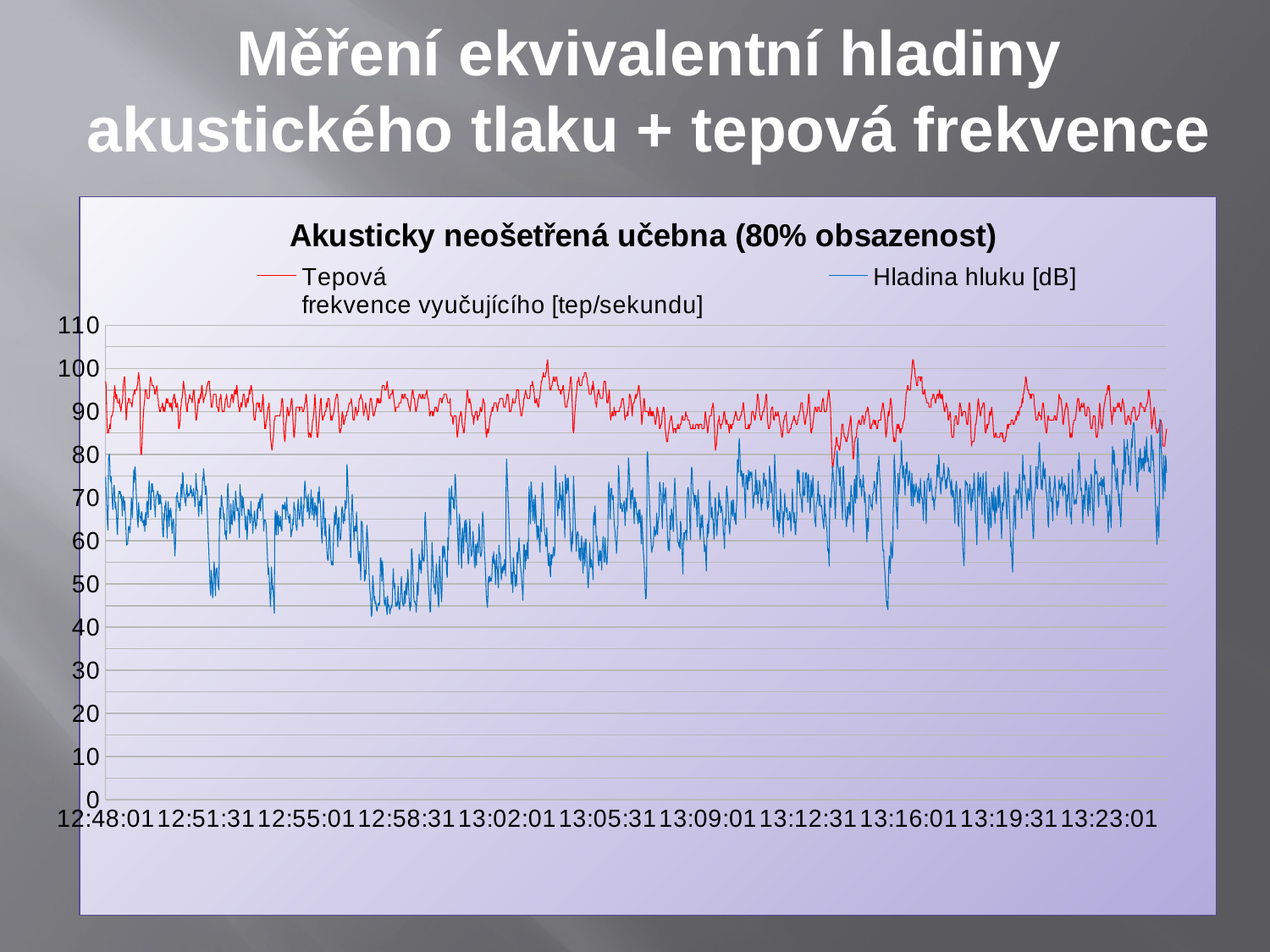
What is the highest value shown on the vertical axis? 110 Is the blue line around 12:58:31 greater or less than 60? less What kind of chart is shown on the slide? line chart What is the first time label on the horizontal axis? 12:48:01 How many series does the chart legend list? 2 Is the red line at the start of the chart (12:48:01) greater or less than 80? greater What is the last time label on the horizontal axis? 13:23:01 Which line is plotted higher on the chart throughout, the red line or the blue line? the red line What are the two series named in the chart legend? Tepová frekvence vyučujícího [tep/sekundu] and Hladina hluku [dB] What is the title of the chart? Akusticky neošetřená učebna (80% obsazenost) Is the red line at any point greater or less than 110? less How many time labels are shown on the horizontal axis? 11